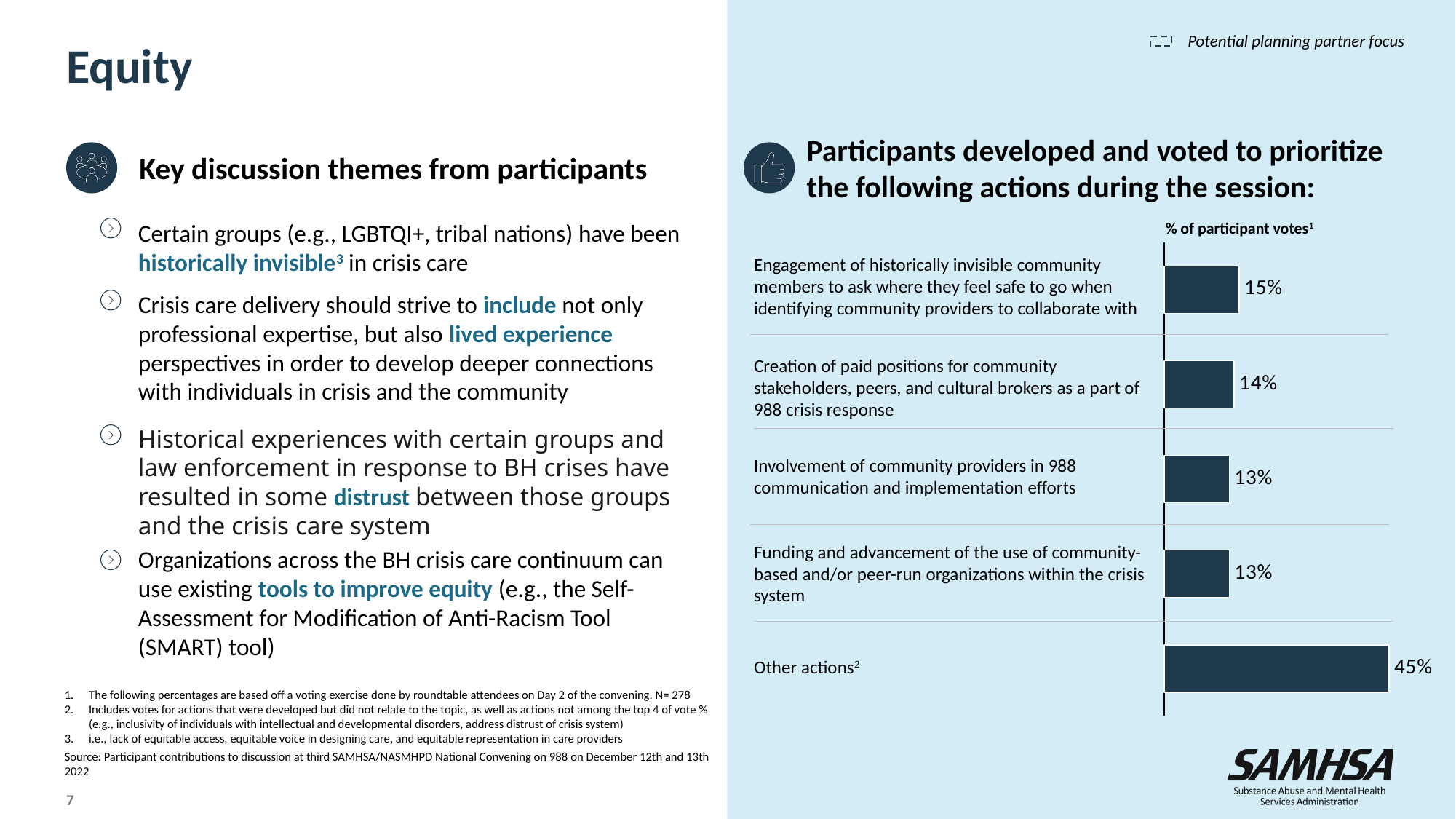
What percentage of participant votes went to "Engagement of historically invisible community members to ask where they feel safe to go when identifying community providers to collaborate with"? 15% Which category received the highest percentage of participant votes? Other actions What percentage of votes did "Involvement of community providers in 988 communication and implementation efforts" receive? 13% What is the difference in percentage points between "Other actions" and the "Engagement of historically invisible community members" action? 30 percentage points What percentage of participant votes did "Other actions" receive? 45% What is the difference between the vote share for "Engagement of historically invisible community members" and "Creation of paid positions for community stakeholders, peers, and cultural brokers"? 1 percentage point What is the label of the value axis shown above the bars? % of participant votes Among the four named actions (excluding "Other actions"), which received the highest percentage of votes? Engagement of historically invisible community members to ask where they feel safe to go when identifying community providers to collaborate with How many categories (bars) are shown in the chart? 5 Which received a larger share of votes: "Creation of paid positions for community stakeholders" or "Funding and advancement of the use of community-based and/or peer-run organizations within the crisis system"? Creation of paid positions for community stakeholders What type of chart is used to show the percentage of participant votes? Bar chart What share of participant votes did "Creation of paid positions for community stakeholders, peers, and cultural brokers as a part of 988 crisis response" receive? 14%